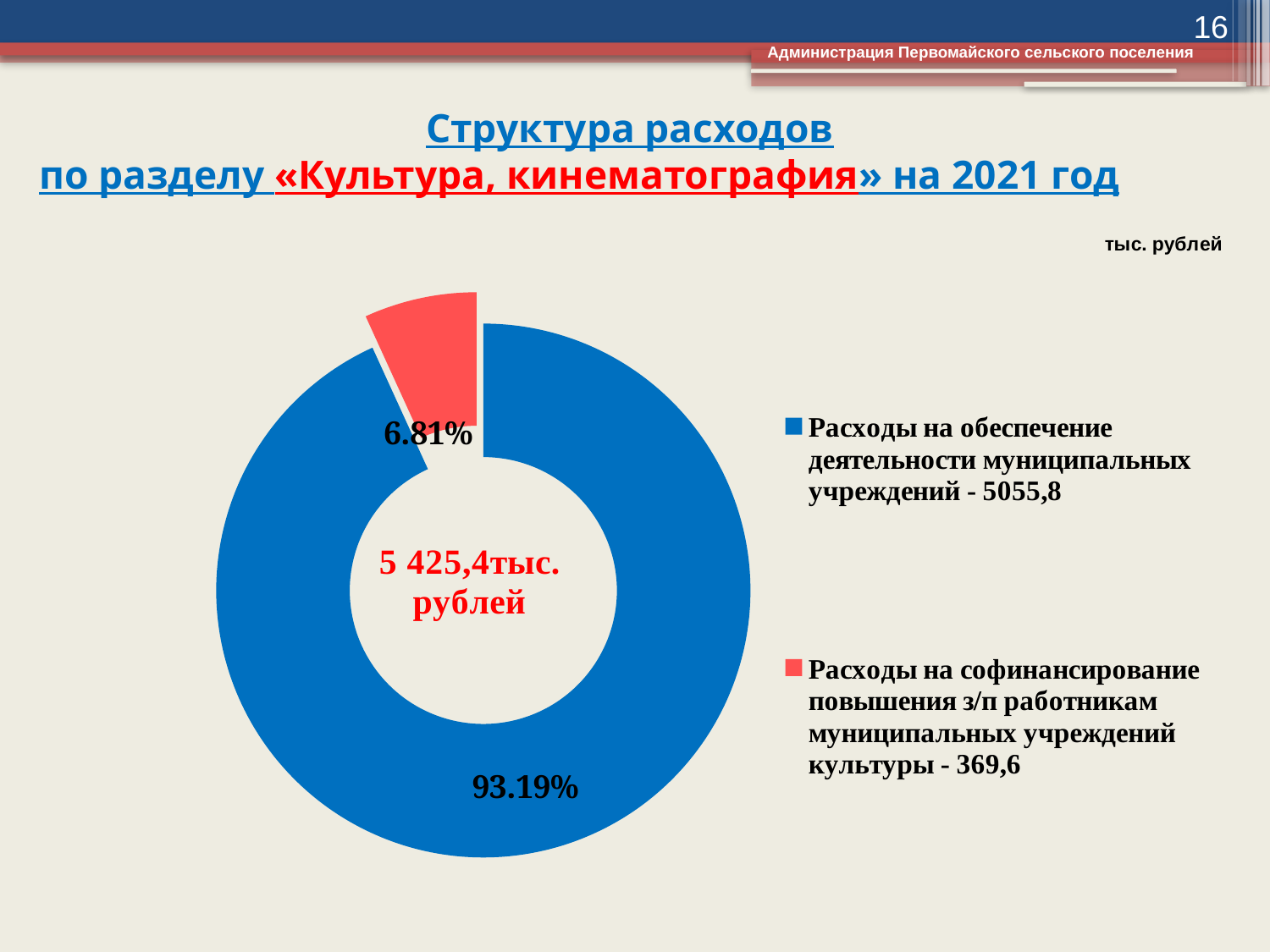
Что больше: расходы на обеспечение деятельности муниципальных учреждений или расходы на софинансирование повышения з/п работникам? Расходы на обеспечение деятельности муниципальных учреждений Какой тип диаграммы показан на слайде? Кольцевая (круговая) диаграмма На сколько процентных пунктов доля расходов на обеспечение деятельности муниципальных учреждений больше доли расходов на софинансирование повышения з/п? 86.38 Каким цветом на диаграмме показаны расходы на софинансирование повышения з/п работникам муниципальных учреждений культуры? Красным Какую долю составляют расходы на обеспечение деятельности муниципальных учреждений? 93.19% Какая категория расходов имеет наименьшую долю? Расходы на софинансирование повышения з/п работникам муниципальных учреждений культуры Какова сумма расходов на обеспечение деятельности муниципальных учреждений (тыс. рублей)? 5055,8 Какая общая сумма расходов указана в центре диаграммы? 5 425,4 тыс. рублей Сколько категорий показано на диаграмме? 2 Какая категория расходов имеет наибольшую долю? Расходы на обеспечение деятельности муниципальных учреждений Какую долю составляют расходы на софинансирование повышения з/п работникам муниципальных учреждений культуры? 6.81% Какова сумма расходов на софинансирование повышения з/п работникам муниципальных учреждений культуры (тыс. рублей)? 369,6